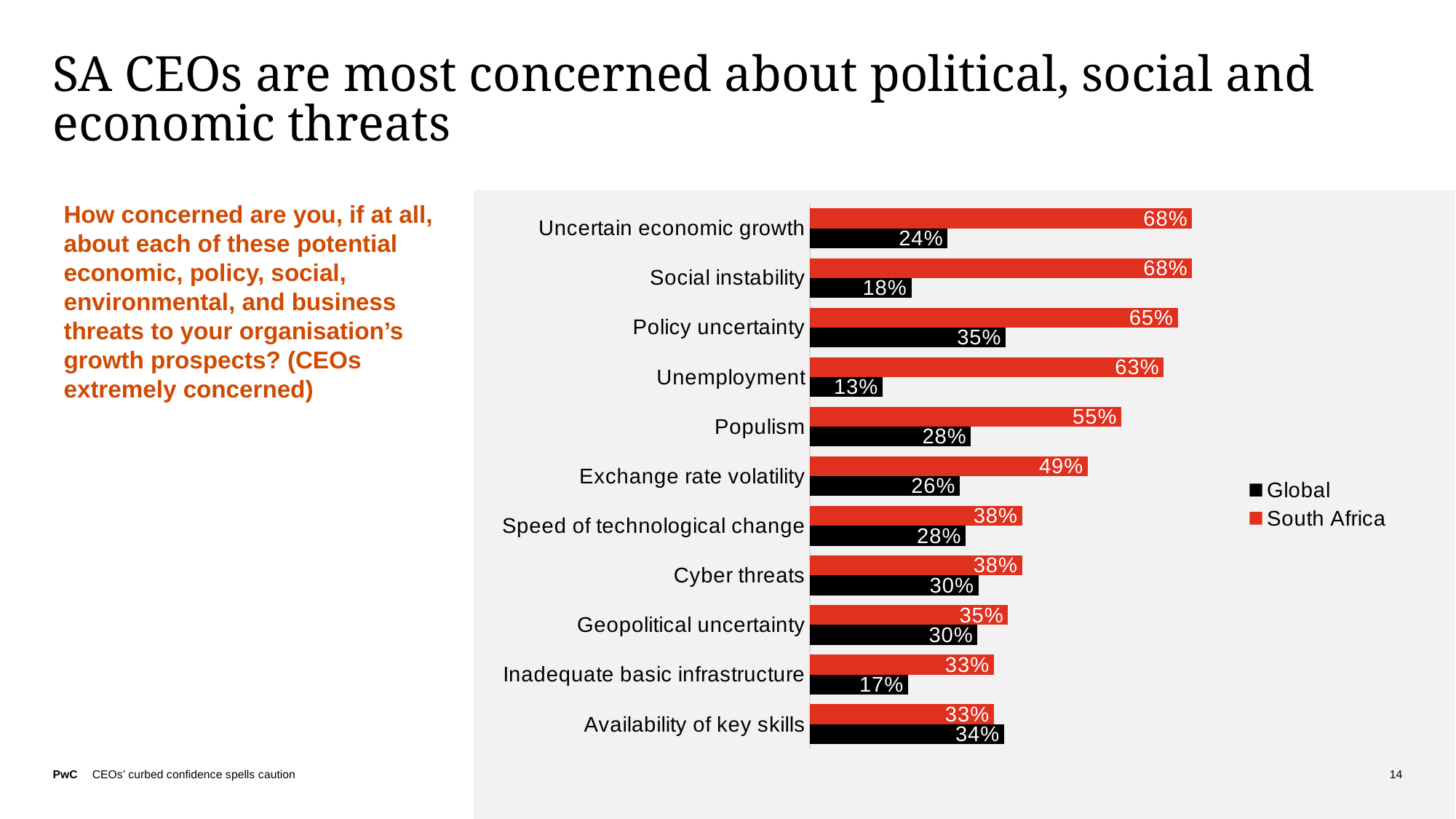
Which is larger for Availability of key skills, the Global value or the South Africa value? Global What kind of chart is shown on the slide? Bar chart What is the Global value for Availability of key skills? 34% What is the South Africa value for Unemployment? 63% What is the difference between the South Africa and Global values for Unemployment? 50 percentage points Which category has the lowest Global value? Unemployment What is the difference between the South Africa and Global values for Social instability? 50 percentage points What is the Global value for Policy uncertainty? 35% Which category has the lowest South Africa value? Inadequate basic infrastructure and Availability of key skills (both 33%) Which is larger, the South Africa value for Populism or the South Africa value for Exchange rate volatility? Populism How many categories are shown in the chart? 11 How many series does the legend list? 2